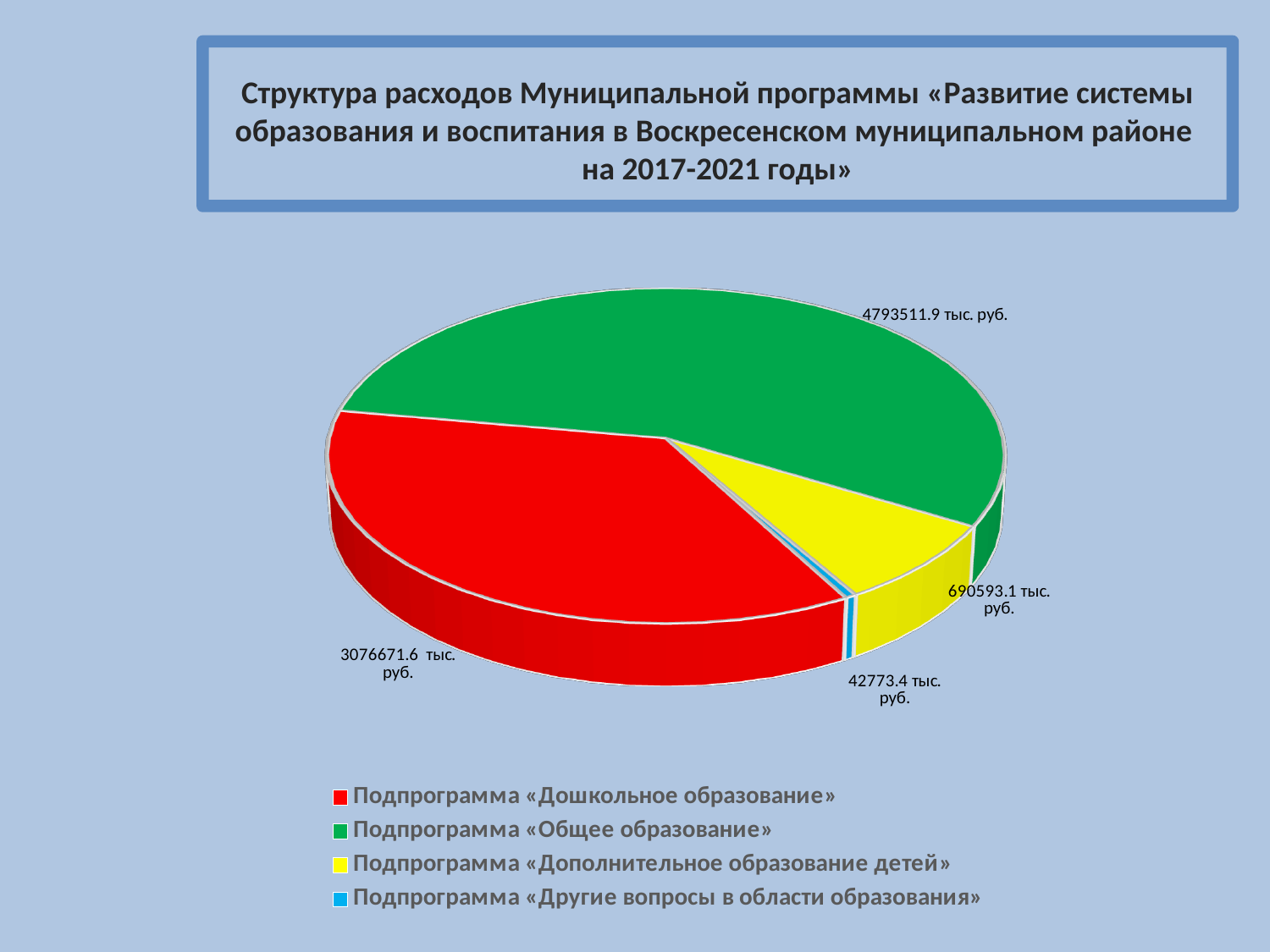
What is the value for Подпрограмма «Общее образование»? 4793511.9 тыс. руб. Which is larger: the value for Подпрограмма «Дополнительное образование детей» or Подпрограмма «Другие вопросы в области образования»? Подпрограмма «Дополнительное образование детей» Which subprogram has the smallest share of expenses? Подпрограмма «Другие вопросы в области образования» Which subprogram has the largest share of expenses? Подпрограмма «Общее образование» What colour represents Подпрограмма «Дошкольное образование» in the chart? Red What type of chart is shown on the slide? Pie chart How many slices does the pie chart have? 4 What is the value for Подпрограмма «Дошкольное образование»? 3076671.6 тыс. руб. How many entries does the legend list? 4 What is the value for Подпрограмма «Дополнительное образование детей»? 690593.1 тыс. руб. What is the value for Подпрограмма «Другие вопросы в области образования»? 42773.4 тыс. руб. What is the difference between the values for Подпрограмма «Общее образование» and Подпрограмма «Дошкольное образование»? 1716840.3 тыс. руб.